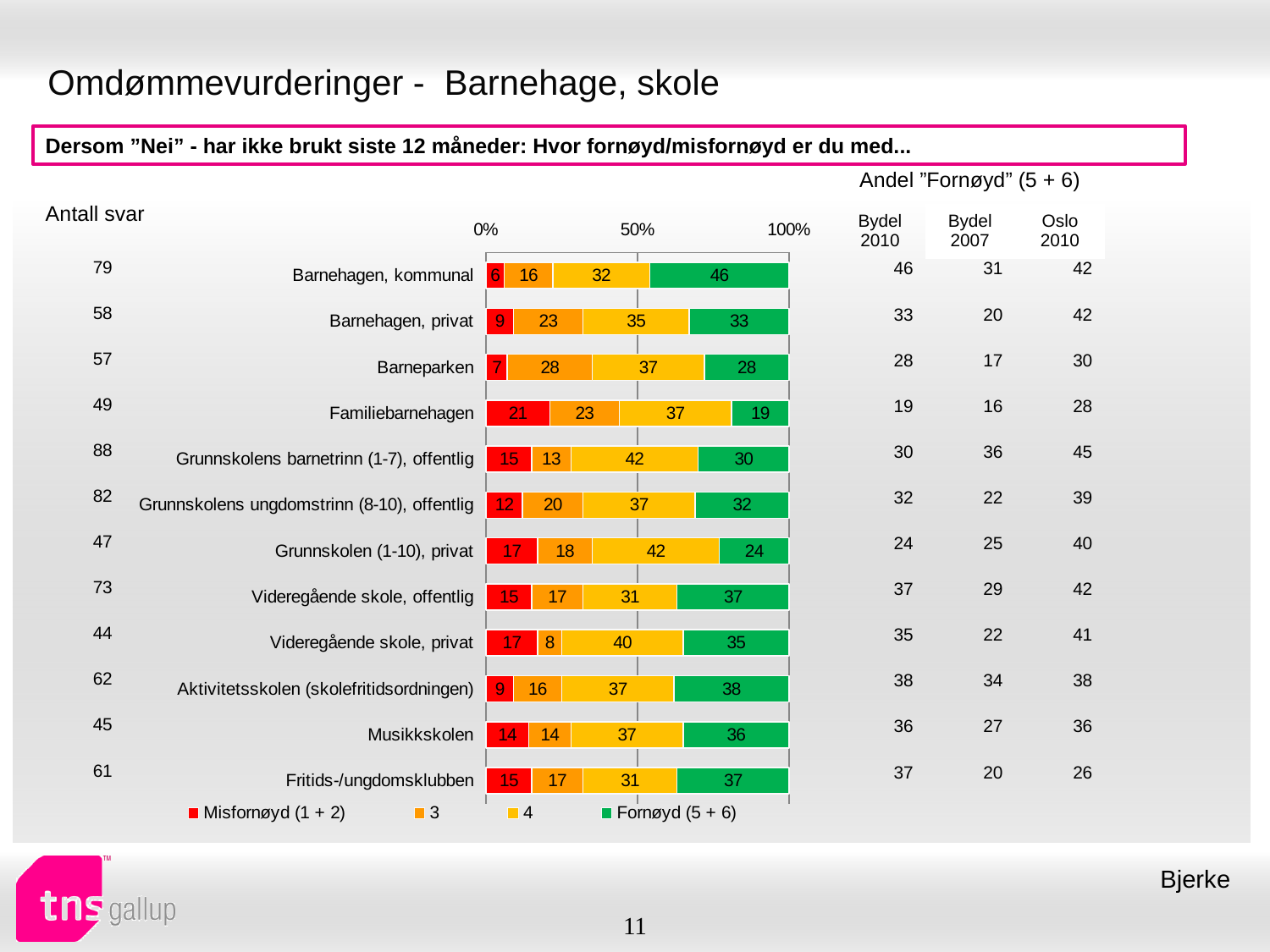
What is the difference between the Fornøyd (5 + 6) values for Barnehagen, kommunal and Familiebarnehagen? 27 Which category has the lowest Fornøyd (5 + 6) value? Familiebarnehagen Which category has the highest Fornøyd (5 + 6) value? Barnehagen, kommunal What is the Fornøyd (5 + 6) value for Barnehagen, kommunal? 46 What is the value of series 4 for Grunnskolen (1-10), privat? 42 What is the Misfornøyd (1 + 2) value for Familiebarnehagen? 21 How many categories are plotted in the chart? 12 What kind of chart is shown on the slide? Stacked bar chart What is the total of the stacked bar for Familiebarnehagen? 100 What is the value of series 3 for Videregående skole, privat? 8 Which is larger: the Fornøyd (5 + 6) value for Aktivitetsskolen (skolefritidsordningen) or for Barneparken? Aktivitetsskolen (skolefritidsordningen) How many series does the chart legend list? 4